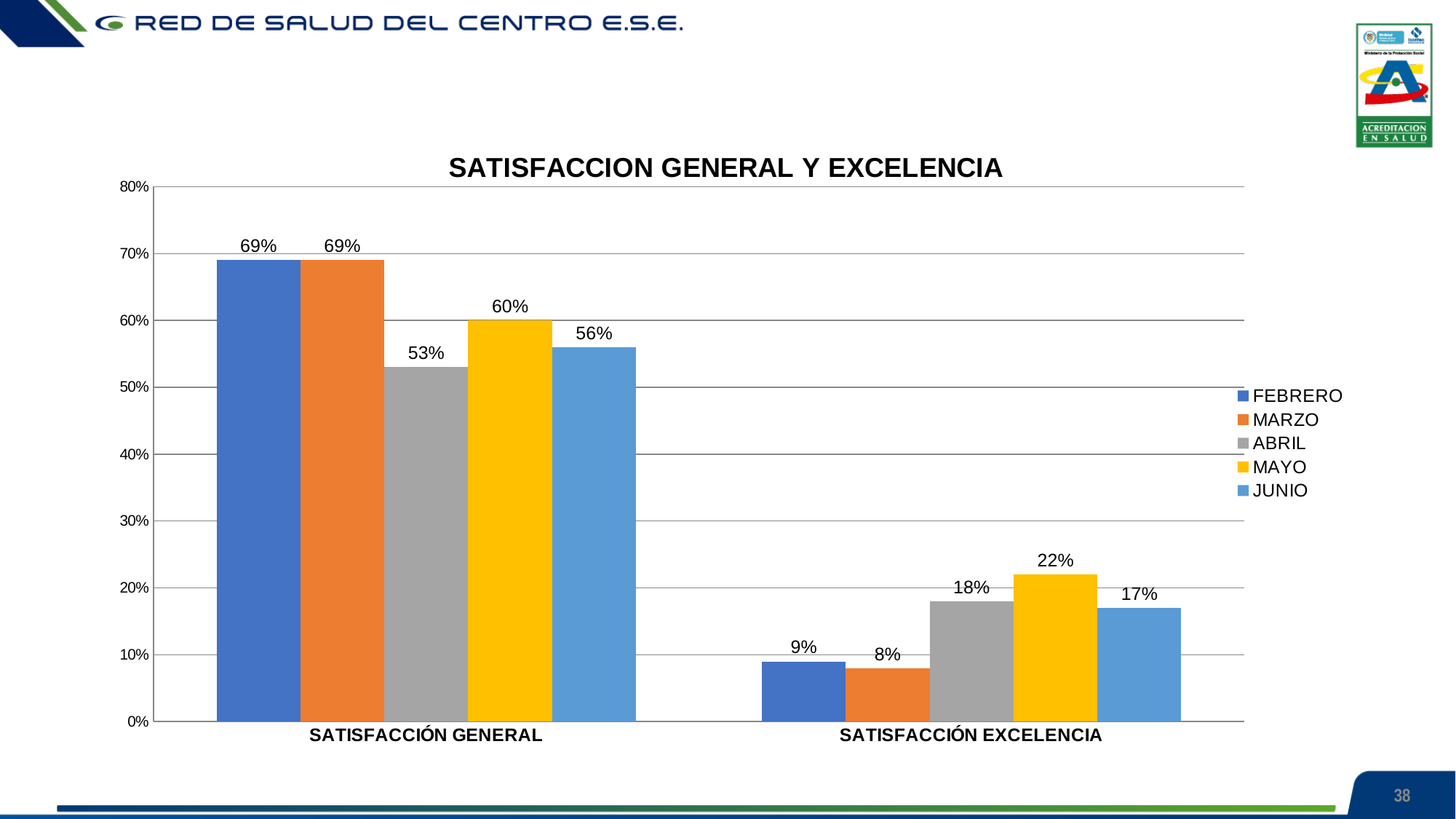
What is the difference between the MAYO and JUNIO values in the SATISFACCIÓN EXCELENCIA category? 5% Which month has the highest value in the SATISFACCIÓN EXCELENCIA category? MAYO How many series does the legend list? 5 What is the value for JUNIO in the SATISFACCIÓN GENERAL category? 56% What is the difference between the MAYO and ABRIL values in the SATISFACCIÓN GENERAL category? 7% What kind of chart is shown on the slide? Bar chart What is the value for MAYO in the SATISFACCIÓN EXCELENCIA category? 22% Which is larger in the SATISFACCIÓN EXCELENCIA category, the value for ABRIL or the value for FEBRERO? ABRIL Which month has the lowest value in the SATISFACCIÓN GENERAL category? ABRIL What is the title of the chart? SATISFACCION GENERAL Y EXCELENCIA Which month has the lowest value in the SATISFACCIÓN EXCELENCIA category? MARZO What is the value for ABRIL in the SATISFACCIÓN GENERAL category? 53%